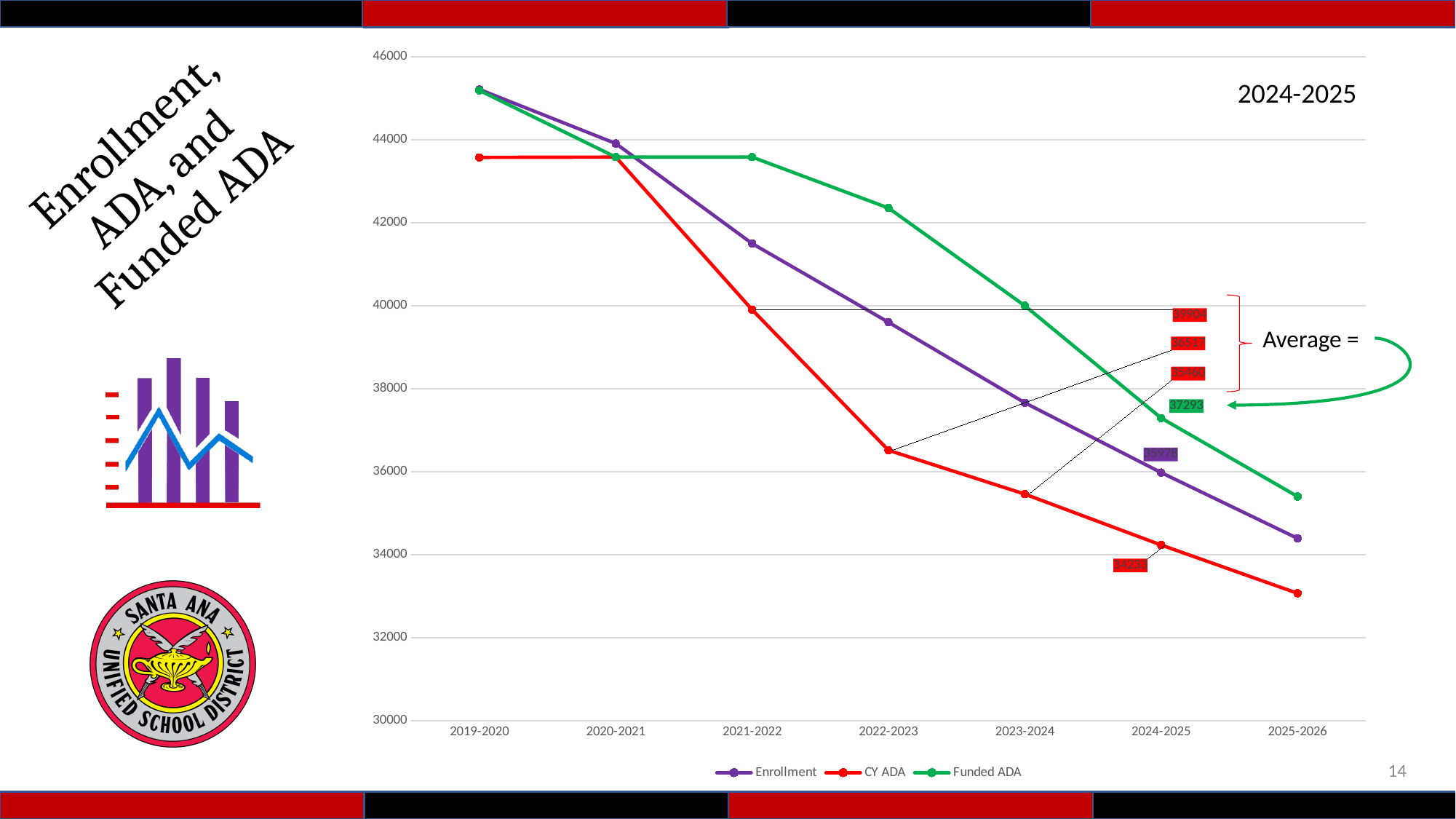
Does the Enrollment series rise or fall from 2019-2020 to 2025-2026? fall Is the Enrollment value for 2019-2020 greater or less than 44000? greater In which school year is CY ADA at its lowest? 2025-2026 What is the labelled Funded ADA value for 2024-2025? 37293 Is the CY ADA value for 2025-2026 greater or less than 34000? less Which series is drawn in green on the chart? Funded ADA Is the Enrollment value for 2021-2022 greater or less than 40000? greater What kind of chart is shown on the slide? line chart Which is larger in 2023-2024, Funded ADA or CY ADA? Funded ADA How many school years are shown on the x axis of the chart? 7 How many series does the chart legend list? 3 Which series has the highest value in 2025-2026? Funded ADA